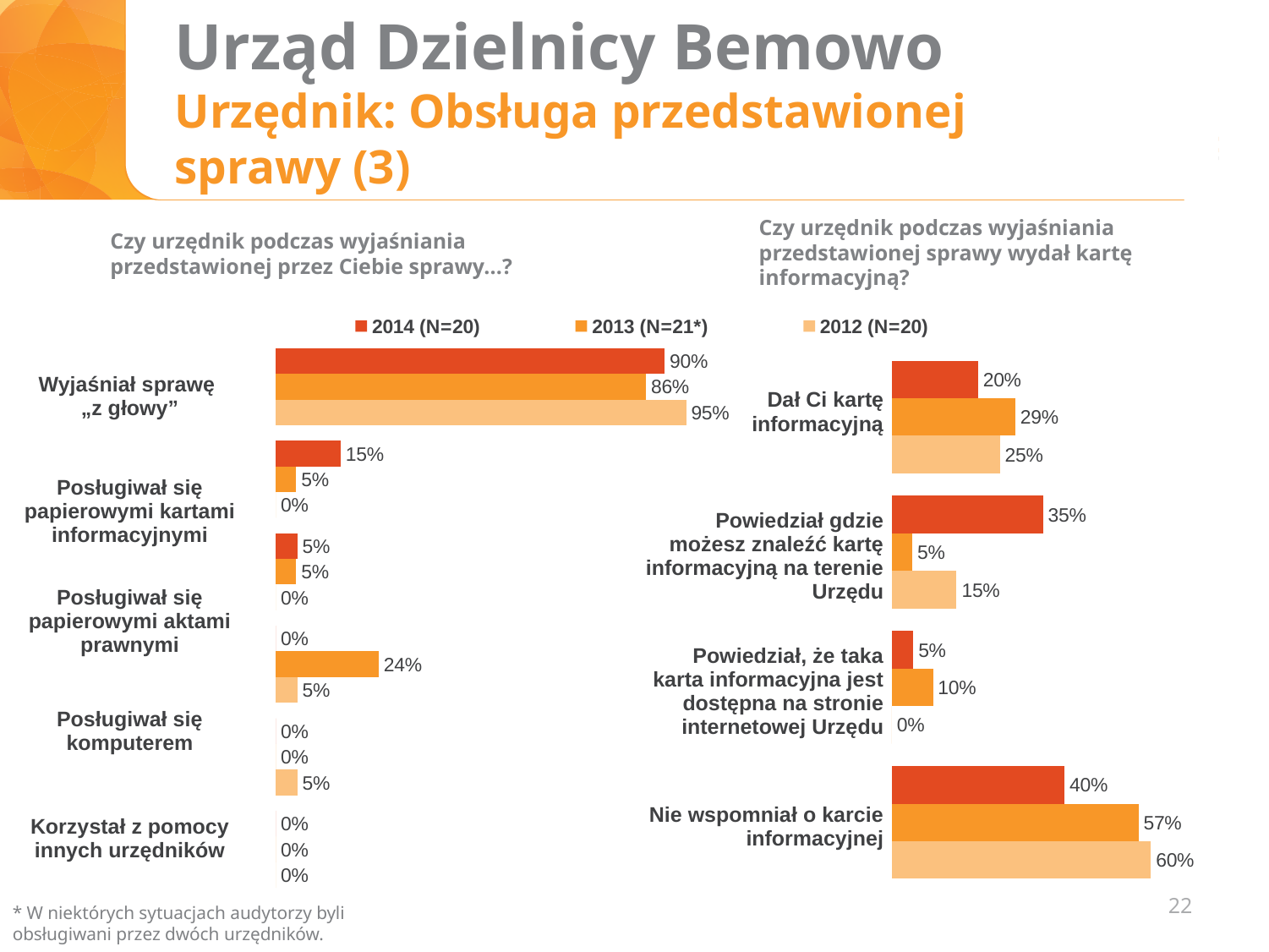
In the right chart, for "Powiedział gdzie możesz znaleźć kartę informacyjną na terenie Urzędu", which year has the larger value, 2014 or 2013? 2014 In the right chart, how many categories are shown? 4 In the left chart ("Czy urzędnik podczas wyjaśniania przedstawionej przez Ciebie sprawy...?"), what is the 2012 value for "Wyjaśniał sprawę „z głowy”"? 95% In the left chart, what is the difference between the 2012 and 2013 values for "Wyjaśniał sprawę „z głowy”"? 9% In the right chart, what is the difference between the 2012 and 2014 values for "Nie wspomniał o karcie informacyjnej"? 20% In the left chart, what is the 2013 value for "Wyjaśniał sprawę „z głowy”"? 86% In the right chart, which category has the highest 2012 value? Nie wspomniał o karcie informacyjnej How many series does the legend list? 3 In the right chart, what is the 2012 value for "Powiedział gdzie możesz znaleźć kartę informacyjną na terenie Urzędu"? 15% In the right chart ("Czy urzędnik podczas wyjaśniania przedstawionej sprawy wydał kartę informacyjną?"), what is the 2014 value for "Nie wspomniał o karcie informacyjnej"? 40% In the right chart, what is the 2013 value for "Dał Ci kartę informacyjną"? 29% What type of chart is used on this slide? Bar chart